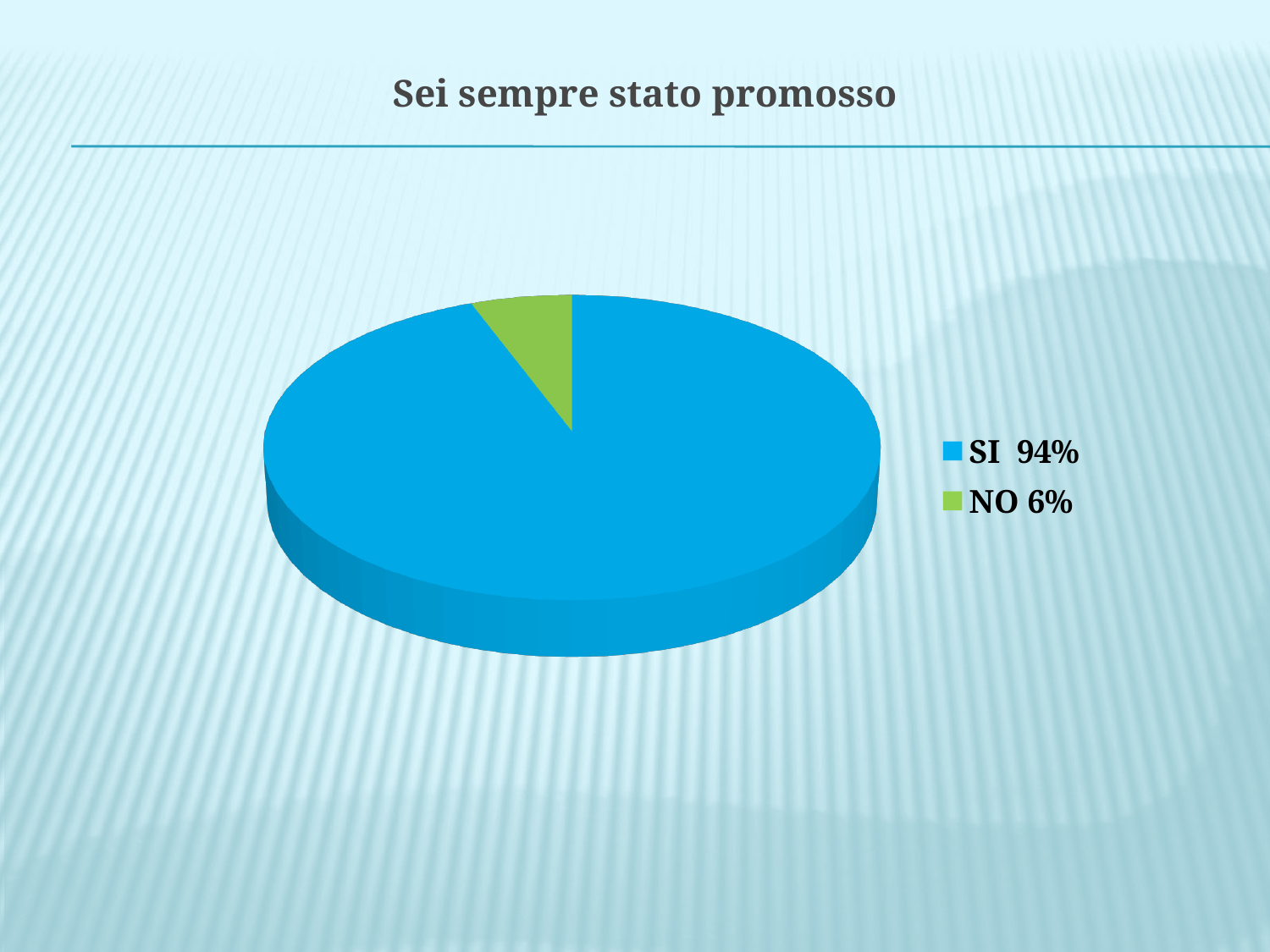
What share of the pie does NO represent? 6% How many slices does the pie chart have? 2 What colour is the slice for NO? green What is the difference in percentage points between SI and NO? 88 Which is larger, the share for SI or the share for NO? SI What share of the pie does SI represent? 94% Which category has the smallest slice of the pie? NO How many entries does the legend list? 2 Which category has the largest slice of the pie? SI What kind of chart is shown on the slide? pie chart What is the title of the chart? Sei sempre stato promosso